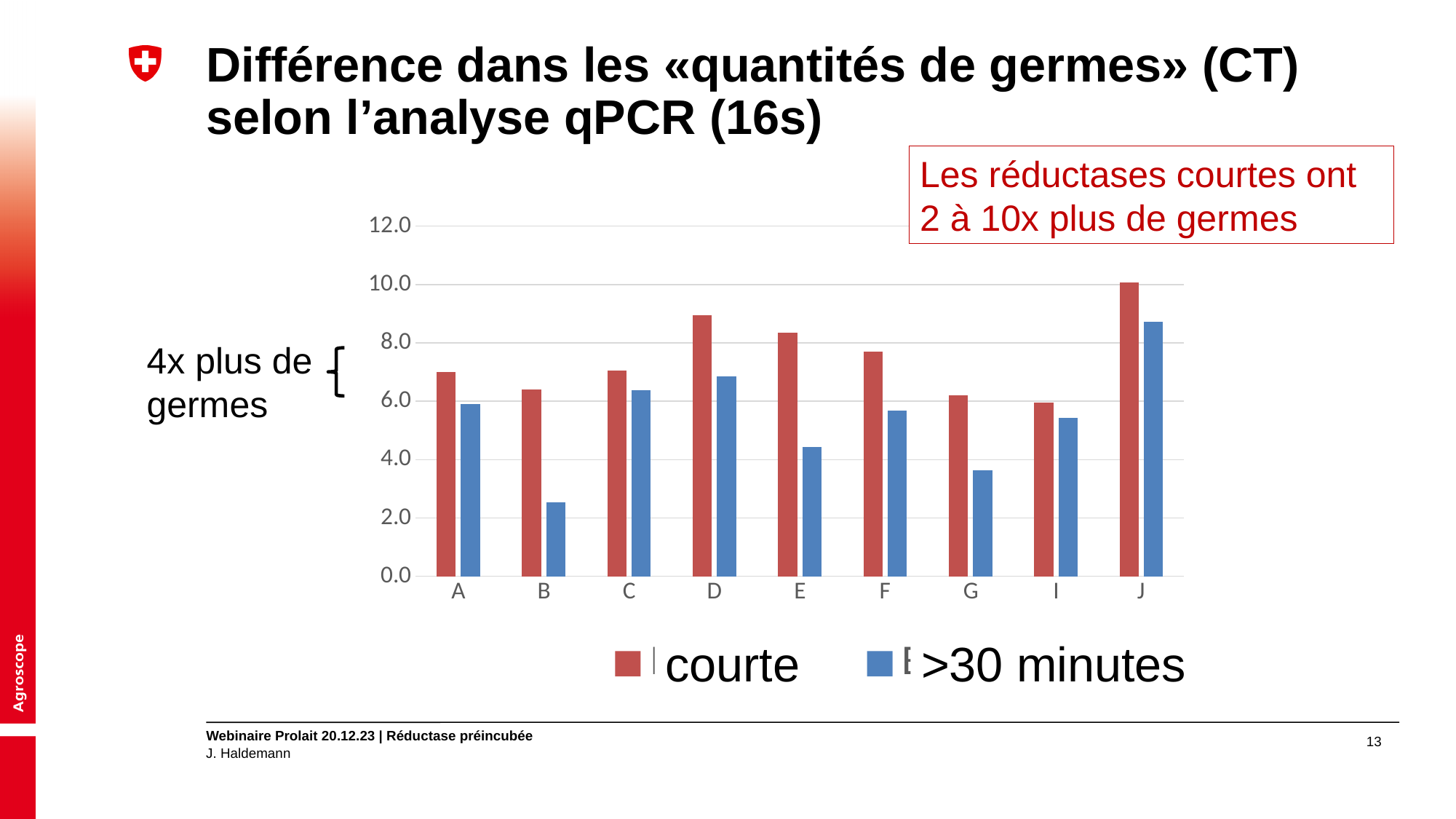
For category E, which series has the larger value, 'courte' or '>30 minutes'? courte Is the 'courte' value for category J greater or less than 8.0? greater Is the '>30 minutes' value for category B greater or less than 4.0? less Which category has the lowest value for the '>30 minutes' series? B What kind of chart is shown on the slide? bar chart What colour are the bars for the 'courte' series? red Is the '>30 minutes' value for category E greater or less than 6.0? less Which category has the highest value for the '>30 minutes' series? J Which category has the highest value for the 'courte' series? J How many series does the chart's legend list? 2 How many categories are shown along the x axis of the chart? 9